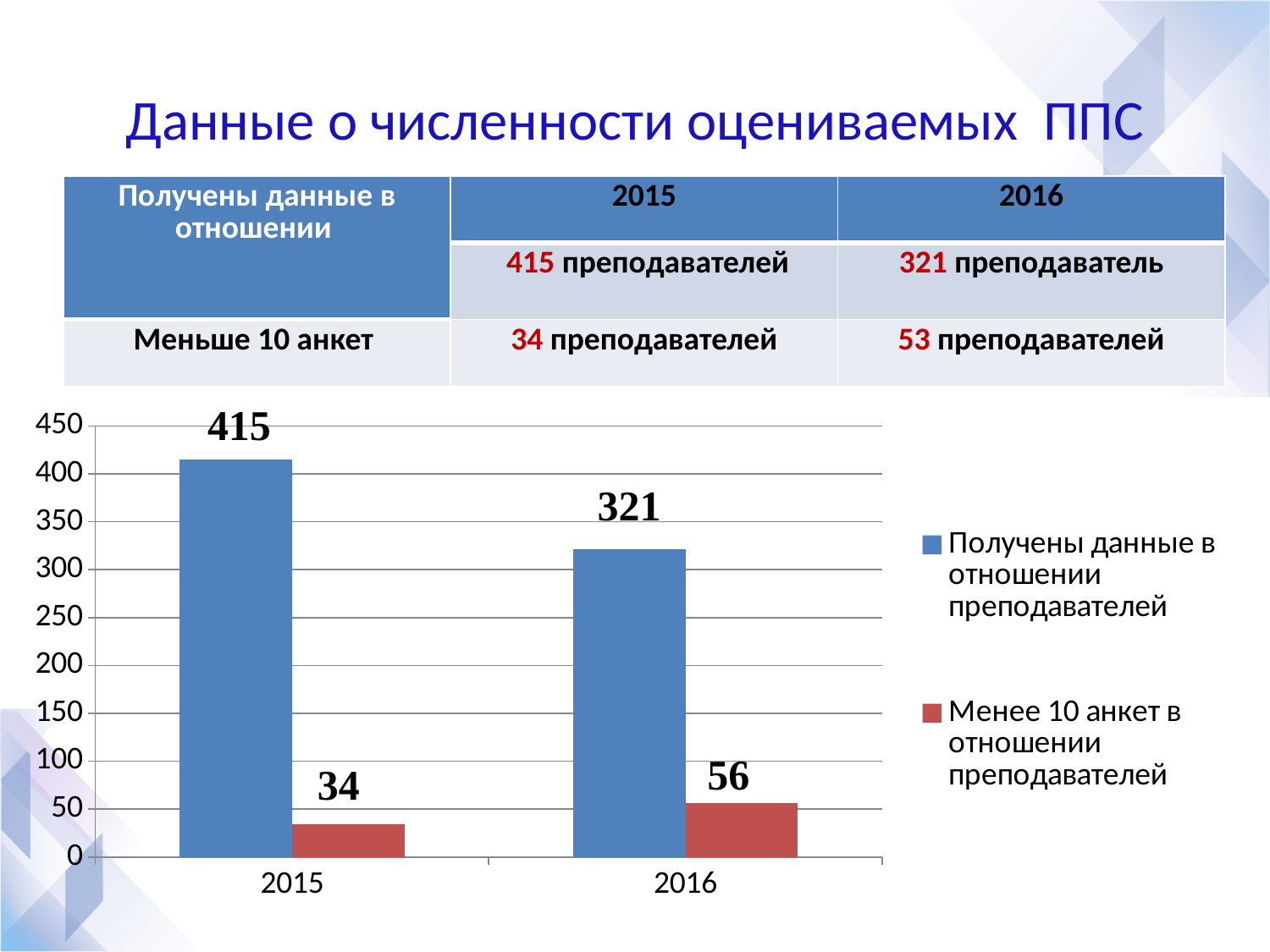
What is the value of the series "Менее 10 анкет в отношении преподавателей" for 2015? 34 What is the value of the series "Менее 10 анкет в отношении преподавателей" for 2016? 56 Which year has the lower value for "Менее 10 анкет в отношении преподавателей"? 2015 Does the value of "Получены данные в отношении преподавателей" rise or fall from 2015 to 2016? fall What type of chart is shown on the slide? bar chart What is the value of the series "Получены данные в отношении преподавателей" for 2016? 321 How many series does the chart legend list? 2 What is the difference between the 2015 and 2016 values of "Получены данные в отношении преподавателей"? 94 What is the value of the series "Получены данные в отношении преподавателей" for 2015? 415 How many categories are shown on the x axis of the chart? 2 What colour are the bars for the series "Менее 10 анкет в отношении преподавателей"? red Which year has the higher value for "Получены данные в отношении преподавателей"? 2015